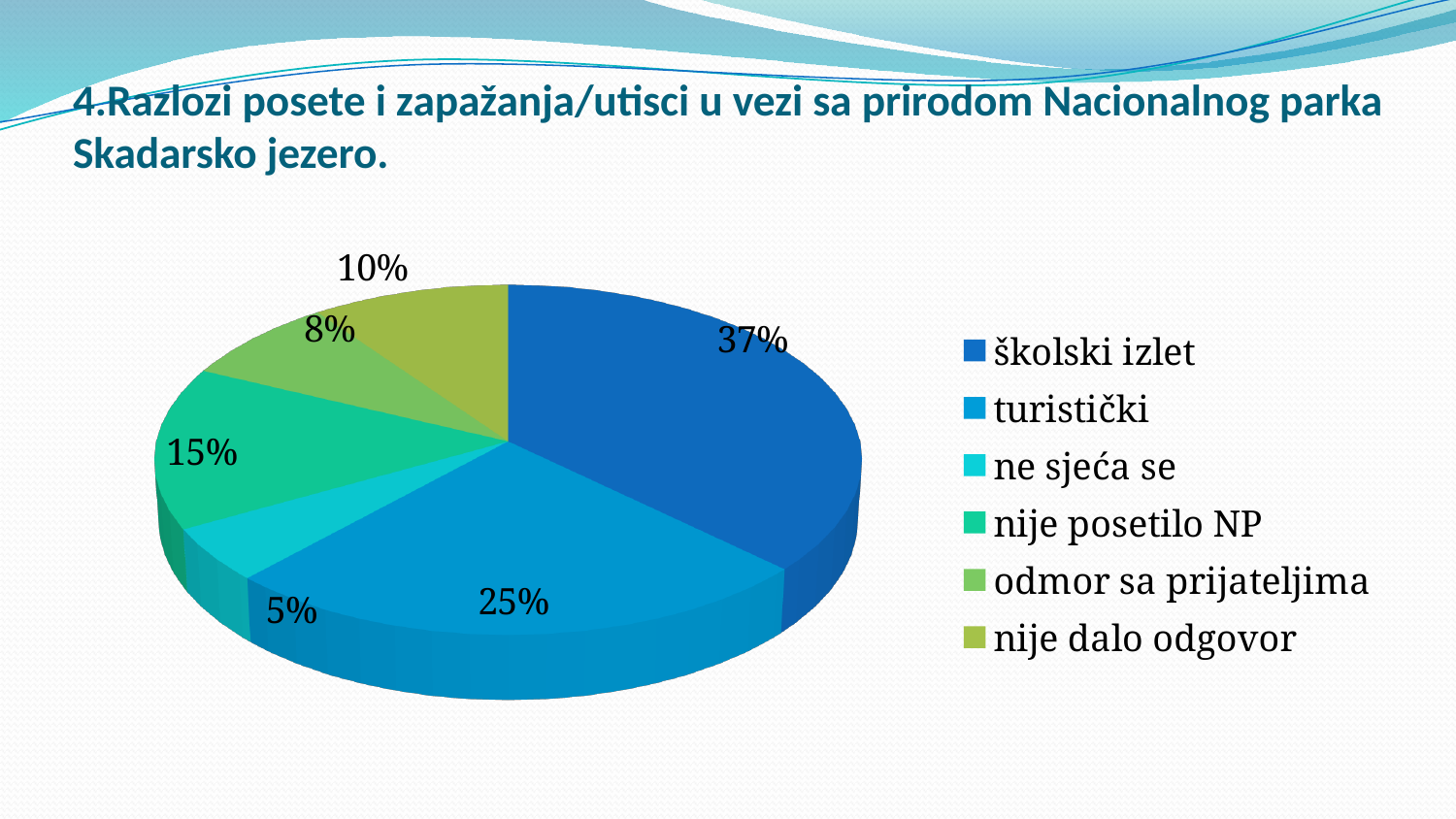
Which category has the largest slice of the pie? školski izlet What is the difference in percentage points between školski izlet and turistički? 12 What share of the pie does nije posetilo NP have? 15% How many categories does the pie chart show? 6 What share of the pie does odmor sa prijateljima have? 8% Which is larger, nije posetilo NP or nije dalo odgovor? nije posetilo NP What is the combined share of školski izlet and turistički? 62% What share of the pie does turistički have? 25% What share of the pie does školski izlet have? 37% What share of the pie does ne sjeća se have? 5% What kind of chart is shown on the slide? pie chart Which category has the smallest slice of the pie? ne sjeća se